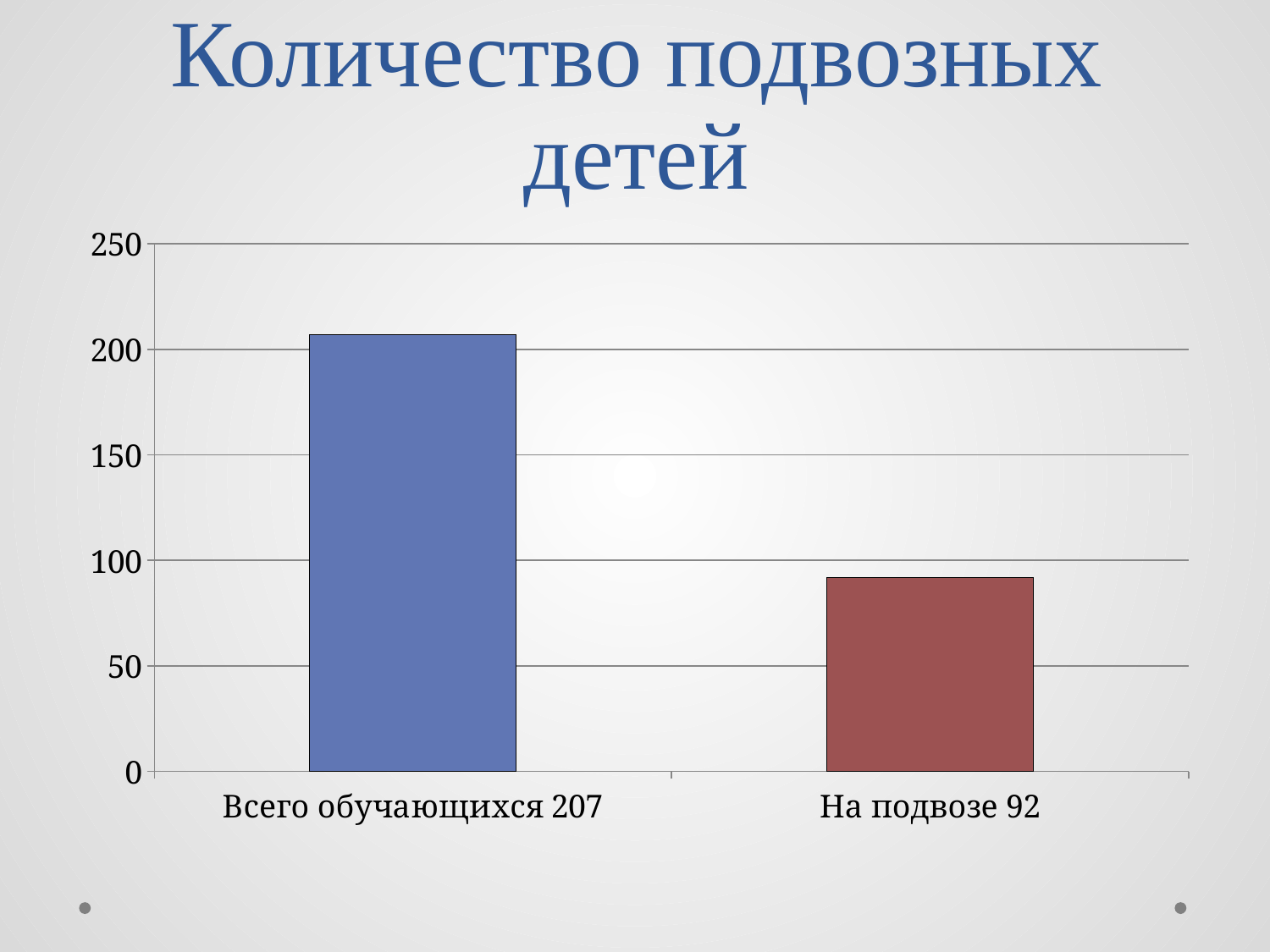
Which category has the lowest value? На подвозе Is the value for "Всего обучающихся" greater or less than 200? greater How many bars does the chart show? 2 What colour is the bar for "На подвозе"? red What is the title of the chart on the slide? Количество подвозных детей What is the value for "Всего обучающихся"? 207 Which is larger: the value for "Всего обучающихся" or the value for "На подвозе"? Всего обучающихся What is the value for "На подвозе"? 92 Is the value for "На подвозе" greater or less than 100? less What type of chart is shown on the slide? bar chart Which category has the highest value? Всего обучающихся What is the difference between the value for "Всего обучающихся" and the value for "На подвозе"? 115